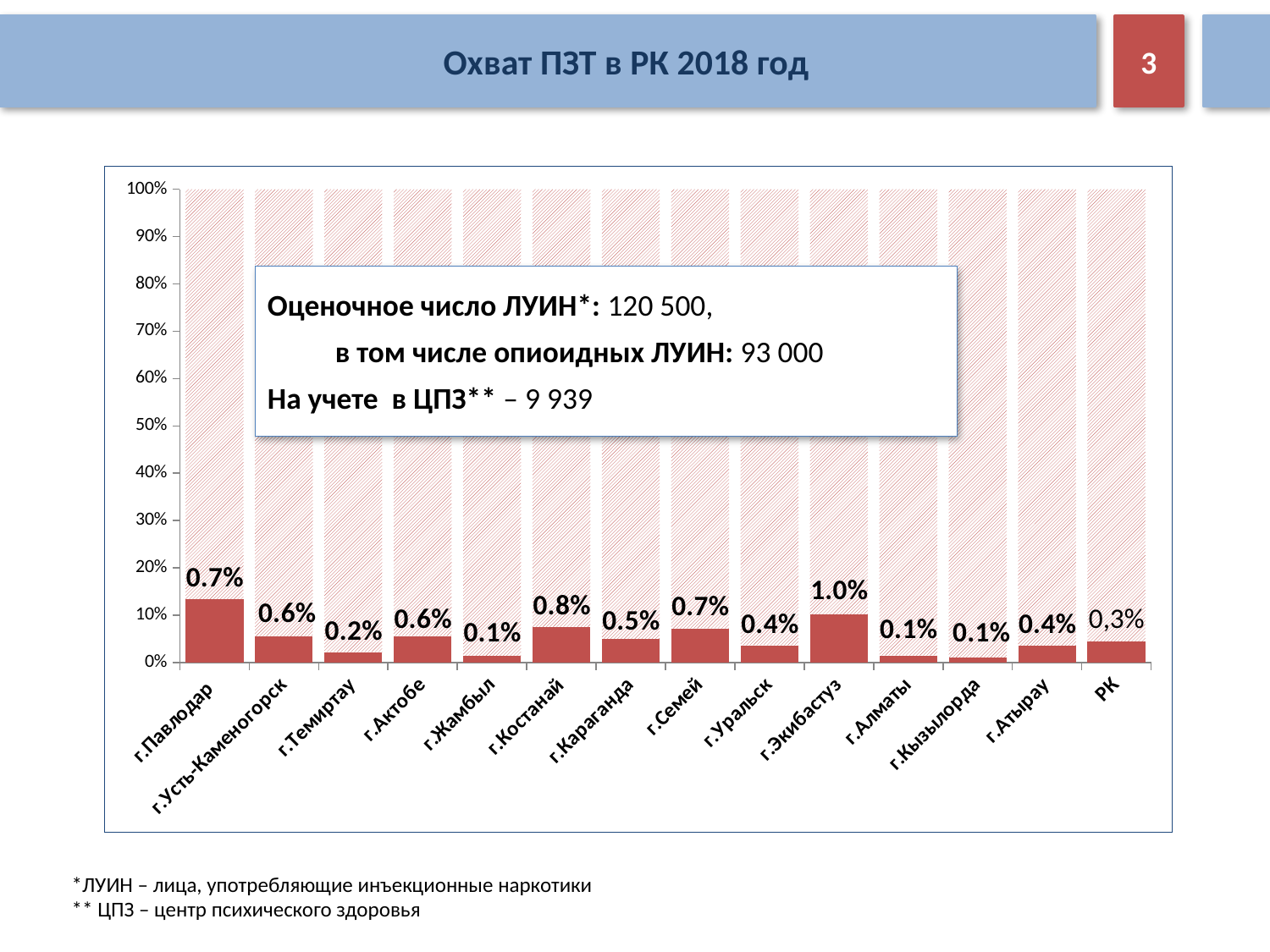
What is the difference between the values for г.Экибастуз and г.Темиртау? 0.8% What is the difference between the values for г.Костанай and г.Уральск? 0.4% How many categories are shown on the x axis? 14 What is the value shown for г.Костанай? 0.8% What is the value shown for г.Экибастуз? 1.0% Which category has the highest value? г.Экибастуз What kind of chart is shown on the slide? bar chart What is the value shown for г.Павлодар? 0.7% What is the value shown for РК? 0,3% Which is larger, the value for г.Костанай or the value for г.Караганда? г.Костанай What is the title of the slide? Охват ПЗТ в РК 2018 год What is the value shown for г.Темиртау? 0.2%